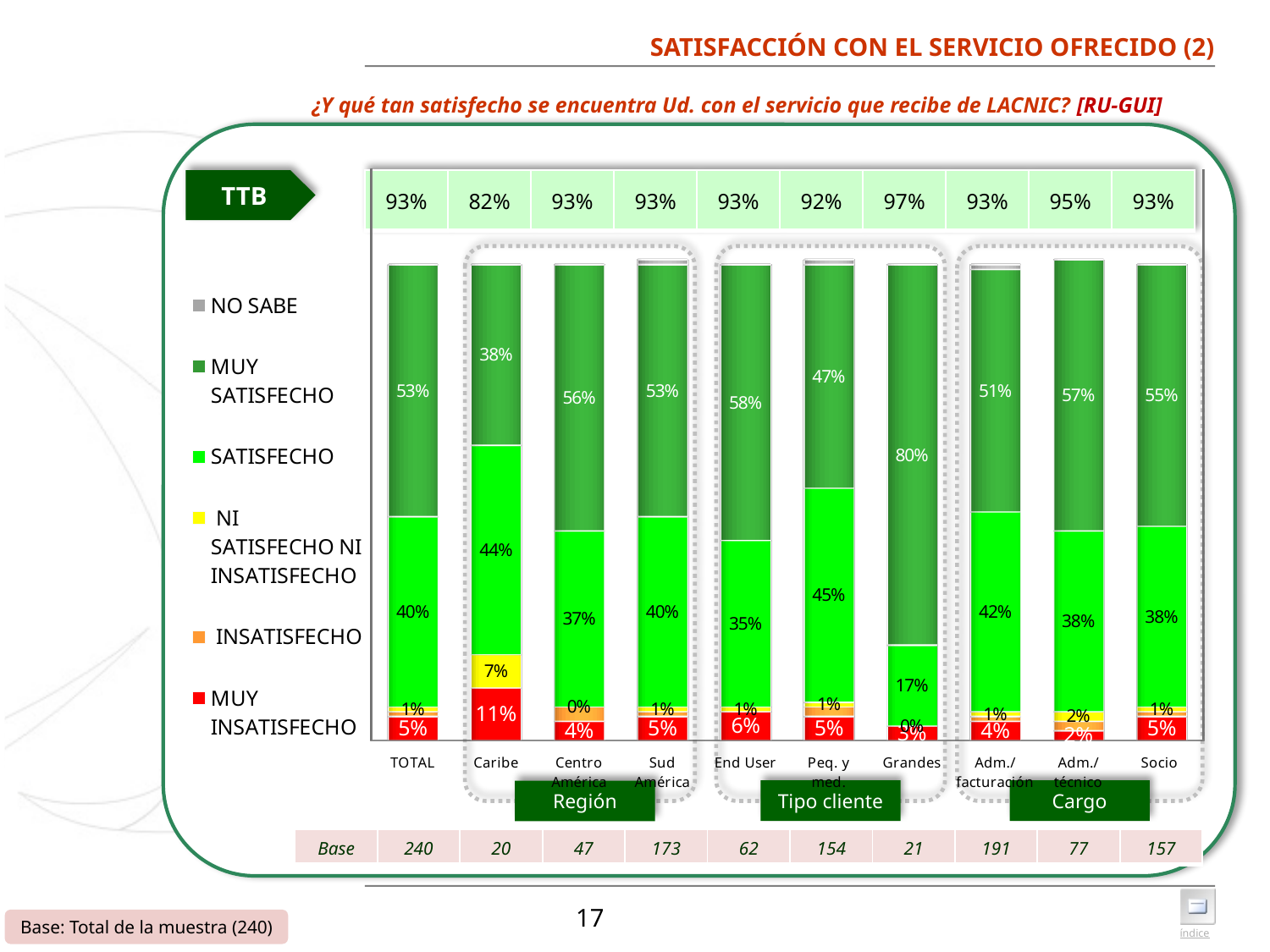
How many categories are plotted along the x axis? 10 What is the NI SATISFECHO NI INSATISFECHO value for Caribe? 7% What is the difference between the MUY SATISFECHO values for Centro América and Caribe? 18% What is the MUY SATISFECHO value for Grandes? 80% Which is larger, the SATISFECHO value for Peq. y med. or for End User? Peq. y med. What kind of chart is shown on the slide? Stacked bar chart Which category has the lowest MUY SATISFECHO value? Caribe What TTB value is shown for Adm./técnico? 95% Which category has the highest MUY SATISFECHO value? Grandes What is the SATISFECHO value for Caribe? 44% What is the MUY INSATISFECHO value for End User? 6% How many series does the legend list? 6